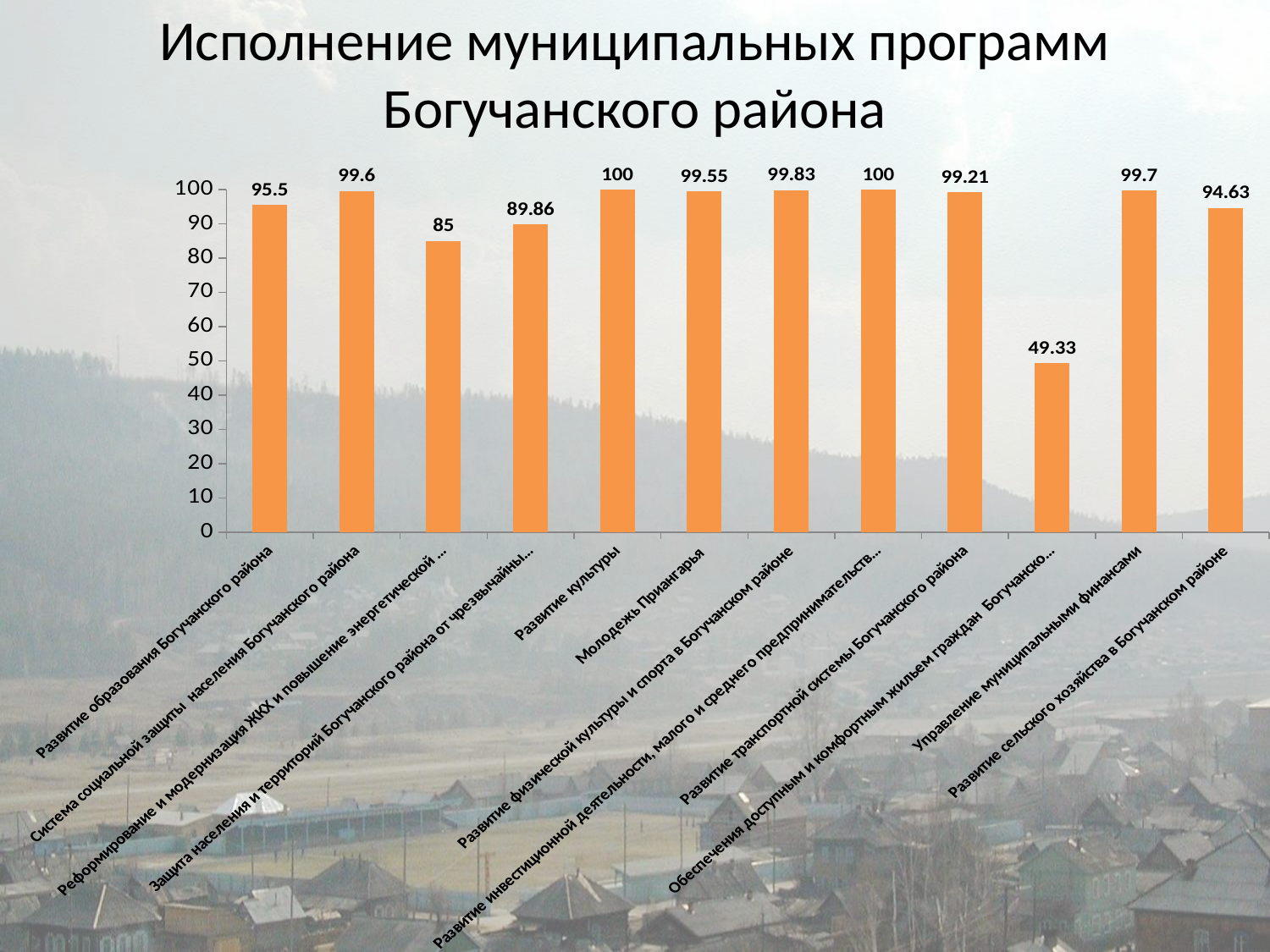
How many bars (programs) are plotted in the chart? 12 What type of chart is shown on the slide? bar chart What is the title of the chart? Исполнение муниципальных программ Богучанского района What is the value for "Управление муниципальными финансами"? 99.7 What is the value for "Молодежь Приангарья"? 99.55 Which is larger: the value for "Развитие транспортной системы Богучанского района" or the value for "Защита населения и территорий Богучанского района от чрезвычайных..."? Развитие транспортной системы Богучанского района What is the value for "Развитие сельского хозяйства в Богучанском районе"? 94.63 Which program has the lowest value in the chart? Обеспечения доступным и комфортным жильем граждан Богучанского района What is the difference between the value for "Система социальной защиты населения Богучанского района" and the value for "Развитие образования Богучанского района"? 4.1 Is the value for "Реформирование и модернизация ЖКХ..." greater or less than 90? less What is the difference between the value for "Развитие культуры" and the value for "Обеспечения доступным и комфортным жильем граждан"? 50.67 What is the value for "Развитие образования Богучанского района"? 95.5